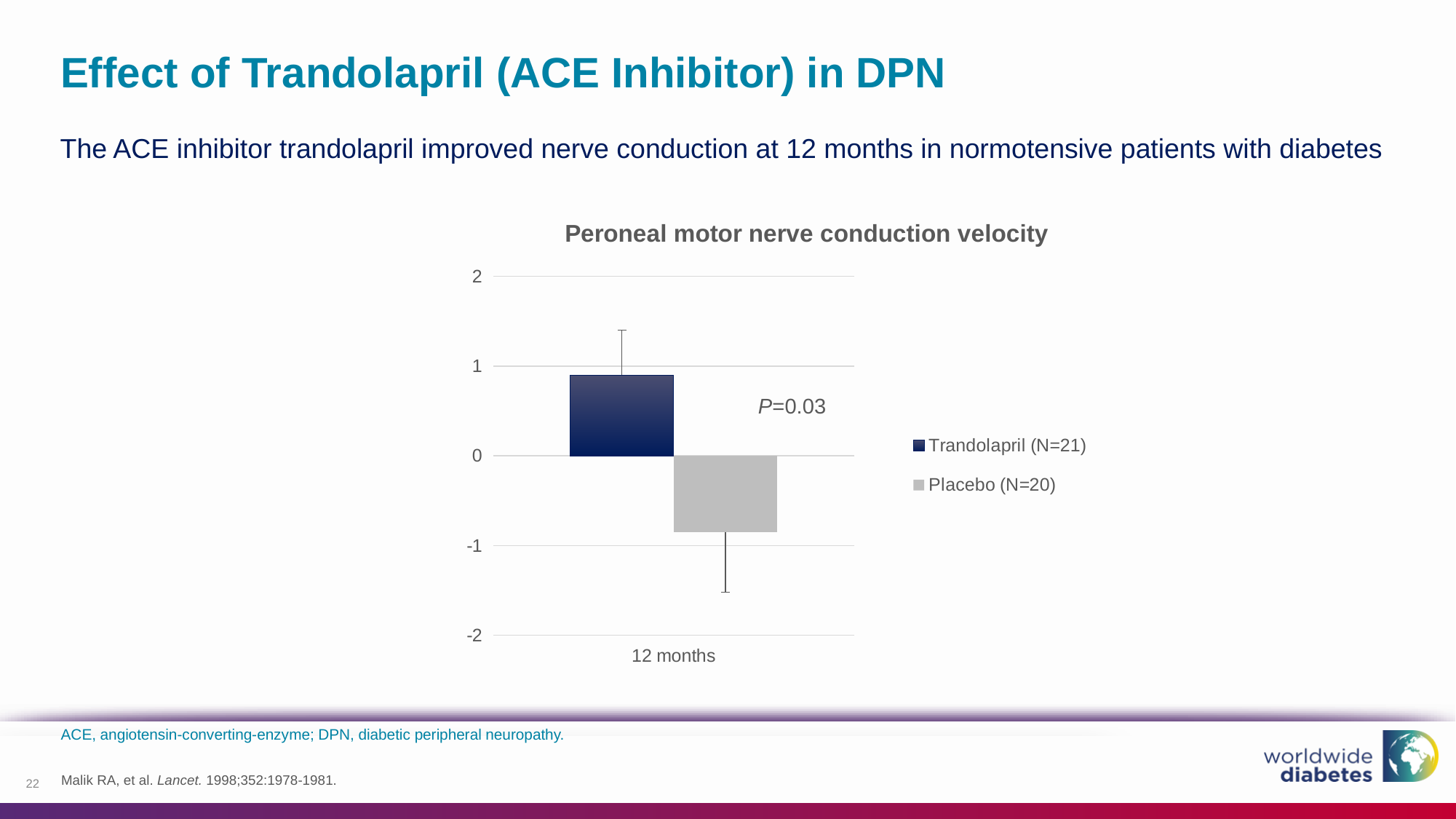
Which series has the lower value at 12 months? Placebo (N=20) Is the value for Placebo (N=20) greater or less than 0? less What is the category label on the x axis? 12 months How many categories are shown on the x axis? 1 Is the value for Placebo (N=20) greater or less than -1? greater Is the value for Trandolapril (N=21) greater or less than 0? greater What is the title of the chart? Peroneal motor nerve conduction velocity How many series does the legend list? 2 What kind of chart is shown on the slide? bar chart Which series has the higher value at 12 months? Trandolapril (N=21)